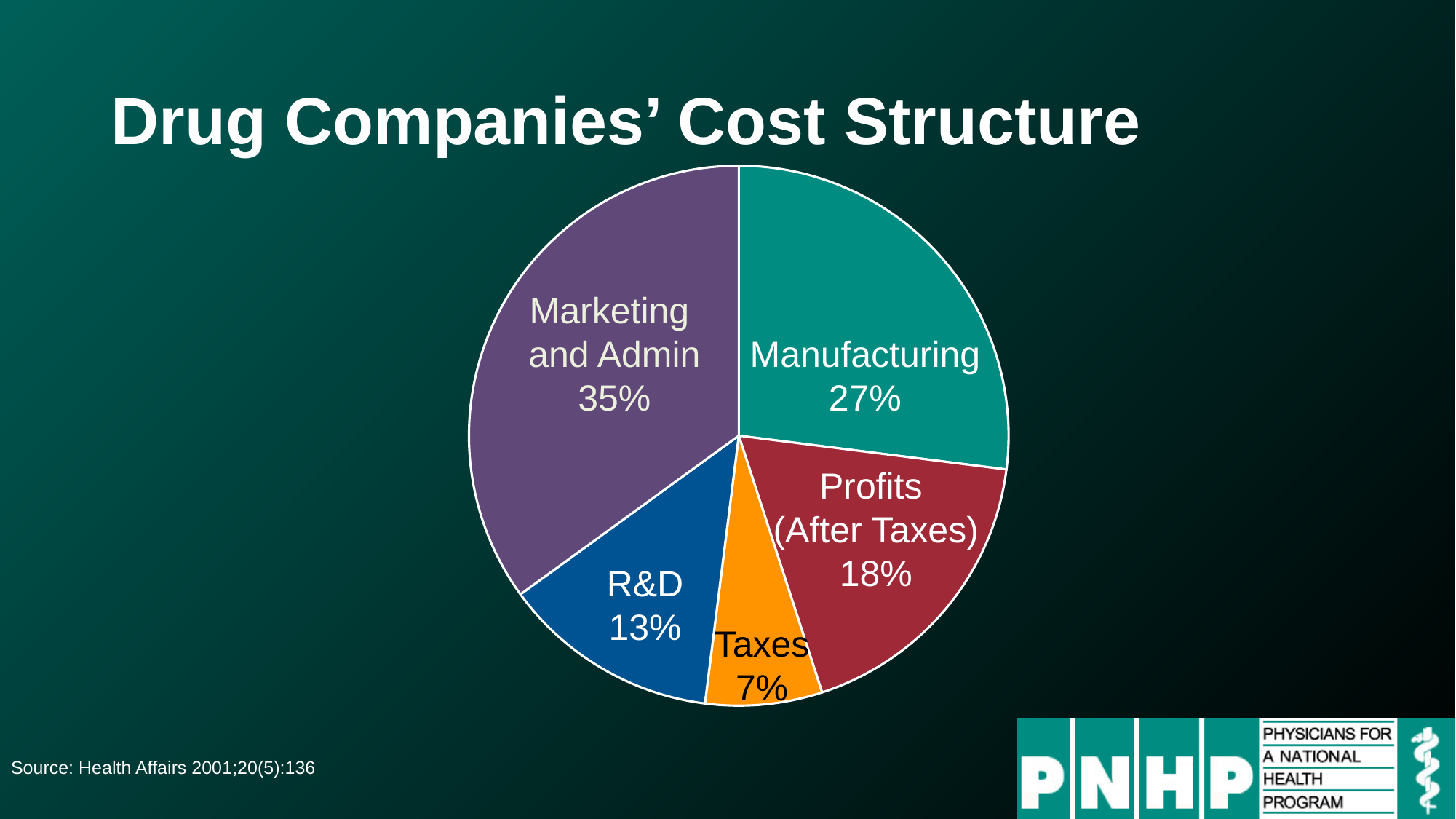
What is the title of the chart? Drug Companies' Cost Structure What kind of chart is shown on the slide? pie chart What is the difference in percentage points between Marketing and Admin and R&D? 22 What percentage is shown for Profits (After Taxes)? 18% What percentage is shown for Manufacturing? 27% What percentage is shown for R&D? 13% Which category has the largest slice of the pie? Marketing and Admin How many slices does the pie chart have? 5 Which category has the smallest slice of the pie? Taxes What share of drug companies' cost structure is Marketing and Admin? 35% What percentage is shown for Taxes? 7% Which is larger, the share for Manufacturing or the share for Profits (After Taxes)? Manufacturing